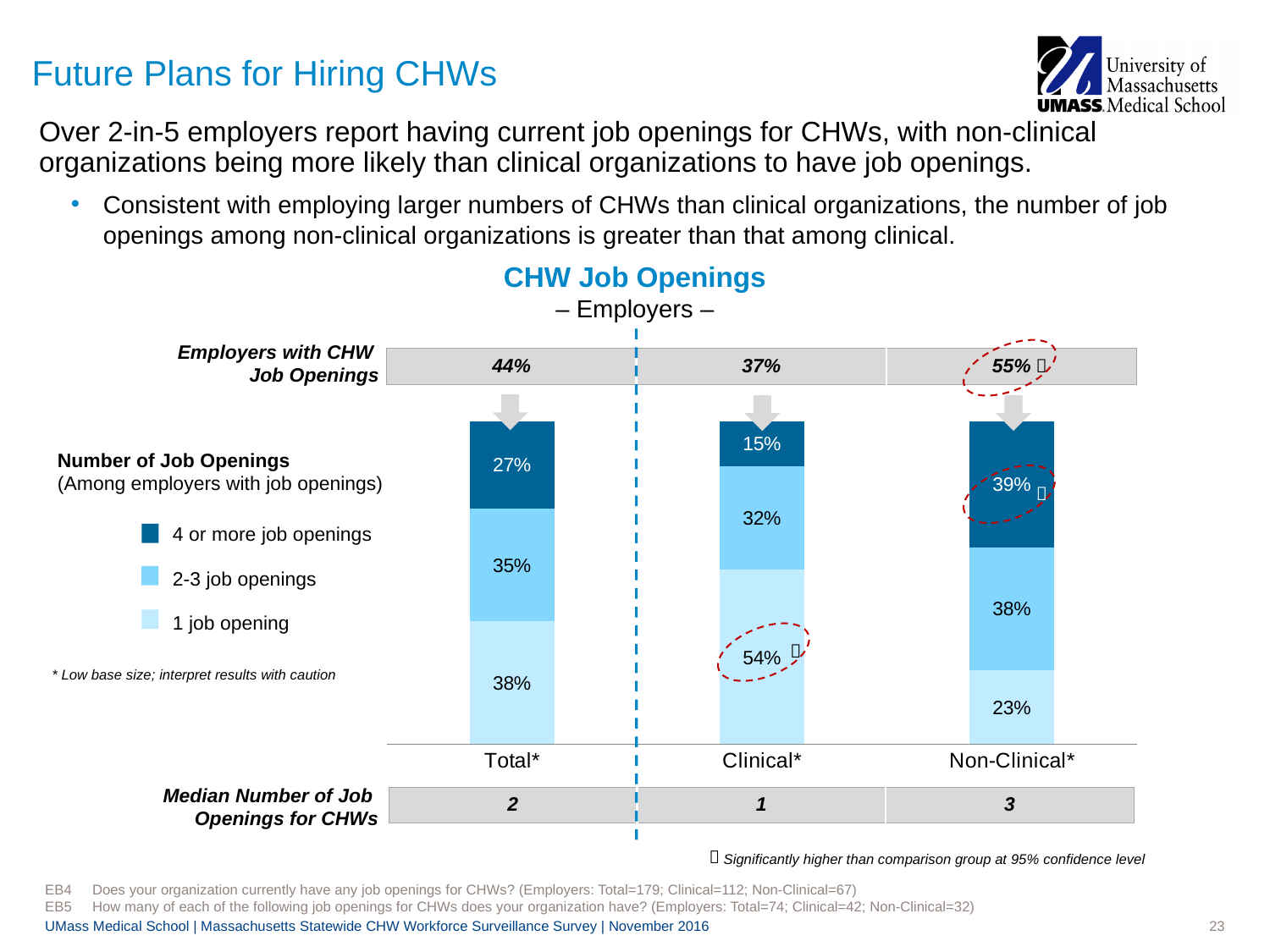
In the CHW Job Openings chart, what percentage of Non-Clinical employers with job openings have 4 or more job openings? 39% In the CHW Job Openings chart, is the 4 or more job openings share larger for Total or for Non-Clinical? Non-Clinical According to the row "Median Number of Job Openings for CHWs" below the chart, what is the median for Clinical employers? 1 What type of chart is shown under the title "CHW Job Openings"? Stacked bar chart According to the row "Employers with CHW Job Openings" above the chart, what percentage of Non-Clinical employers have CHW job openings? 55% How many series does the legend of the CHW Job Openings chart list? 3 In the CHW Job Openings chart, what percentage of Clinical employers with job openings have 1 job opening? 54% In the CHW Job Openings chart, what is the value for 2-3 job openings in the Total category? 35% How many categories are shown along the x axis of the CHW Job Openings chart? 3 Which category has the highest share of employers with 1 job opening in the CHW Job Openings chart? Clinical* Which category has the lowest share of employers with 4 or more job openings in the CHW Job Openings chart? Clinical* In the CHW Job Openings chart, what is the difference between the 1 job opening share for Clinical and for Non-Clinical? 31 percentage points